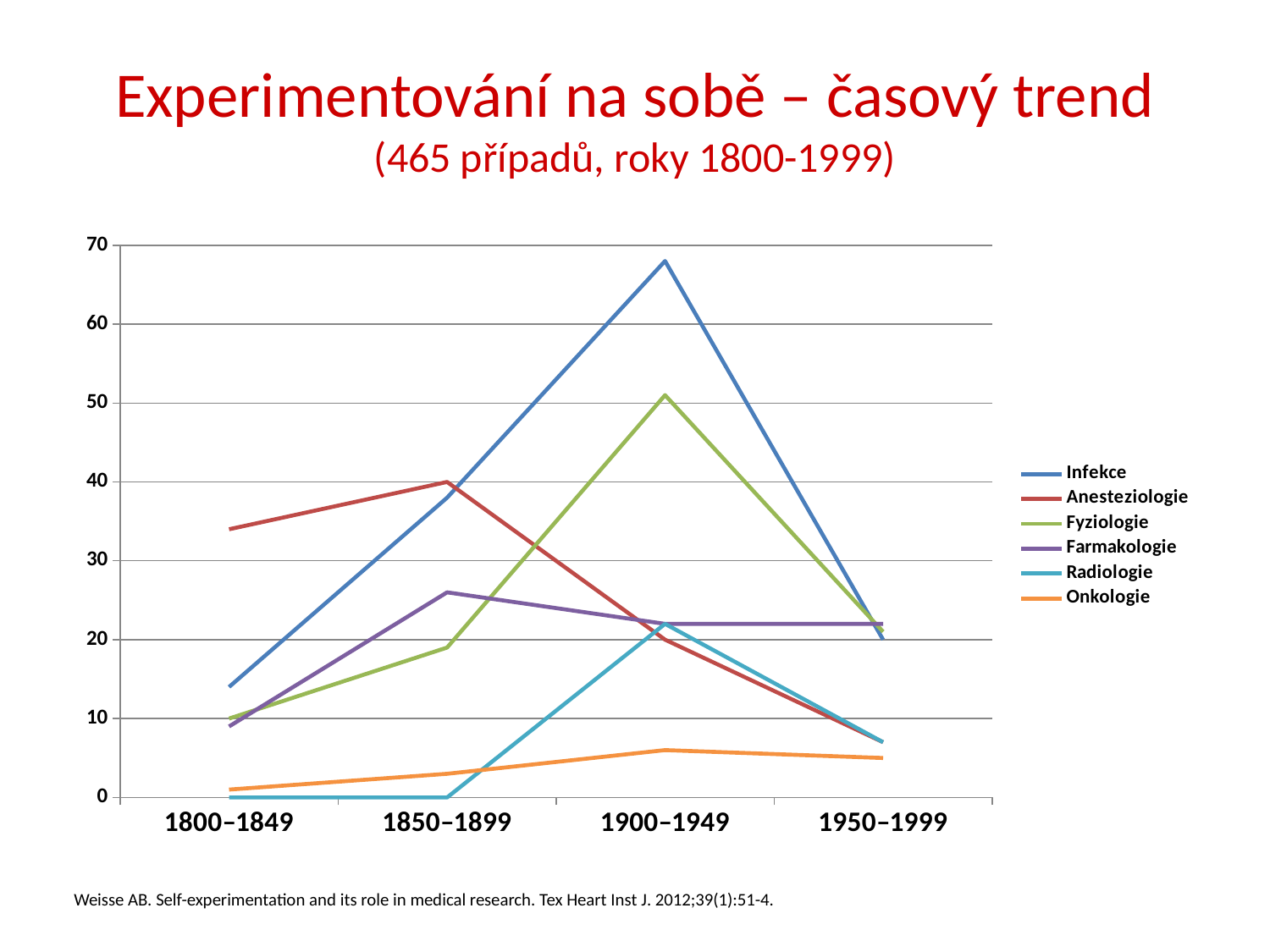
Which series has the highest value in the period 1800–1849? Anesteziologie How many time periods are shown on the x axis? 4 How many series does the legend list? 6 Is the value for Onkologie in 1900–1949 greater or less than 10? less What kind of chart is shown on the slide? line chart Which is larger in 1900–1949, Infekce or Fyziologie? Infekce What is the value for Anesteziologie in 1850–1899? 40 Is the value for Infekce in 1900–1949 greater or less than 60? greater Which series reaches the highest value anywhere on the chart? Infekce What is the value for Radiologie in 1850–1899? 0 Which series has the lowest value in the period 1800–1849? Radiologie In which period does Infekce reach its peak? 1900–1949